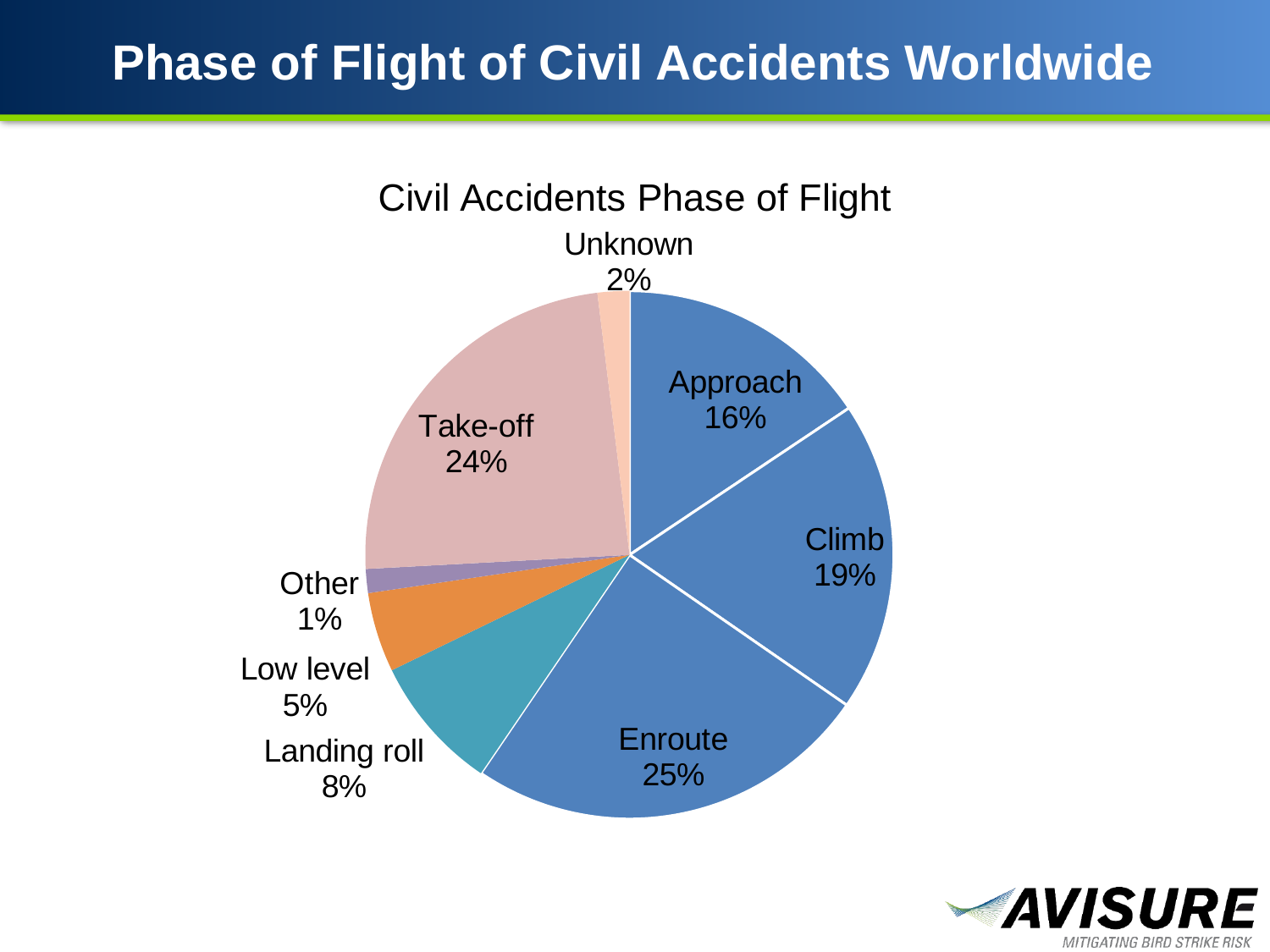
What share of civil accidents has an Unknown phase of flight? 2% Which phase of flight has the smallest share of civil accidents? Other What share of civil accidents occurred during the Climb phase? 19% Which phase of flight has the largest share of civil accidents? Enroute Which has a larger share of civil accidents, Low level or Landing roll? Landing roll What is the difference in percentage points between the Enroute and Approach shares? 9 What share of civil accidents occurred during the Take-off phase? 24% What is the title of the chart? Civil Accidents Phase of Flight What share of civil accidents occurred during the Landing roll phase? 8% What is the combined share of the Take-off and Climb phases? 43% What kind of chart is shown on the slide? Pie chart How many slices does the pie chart have? 8